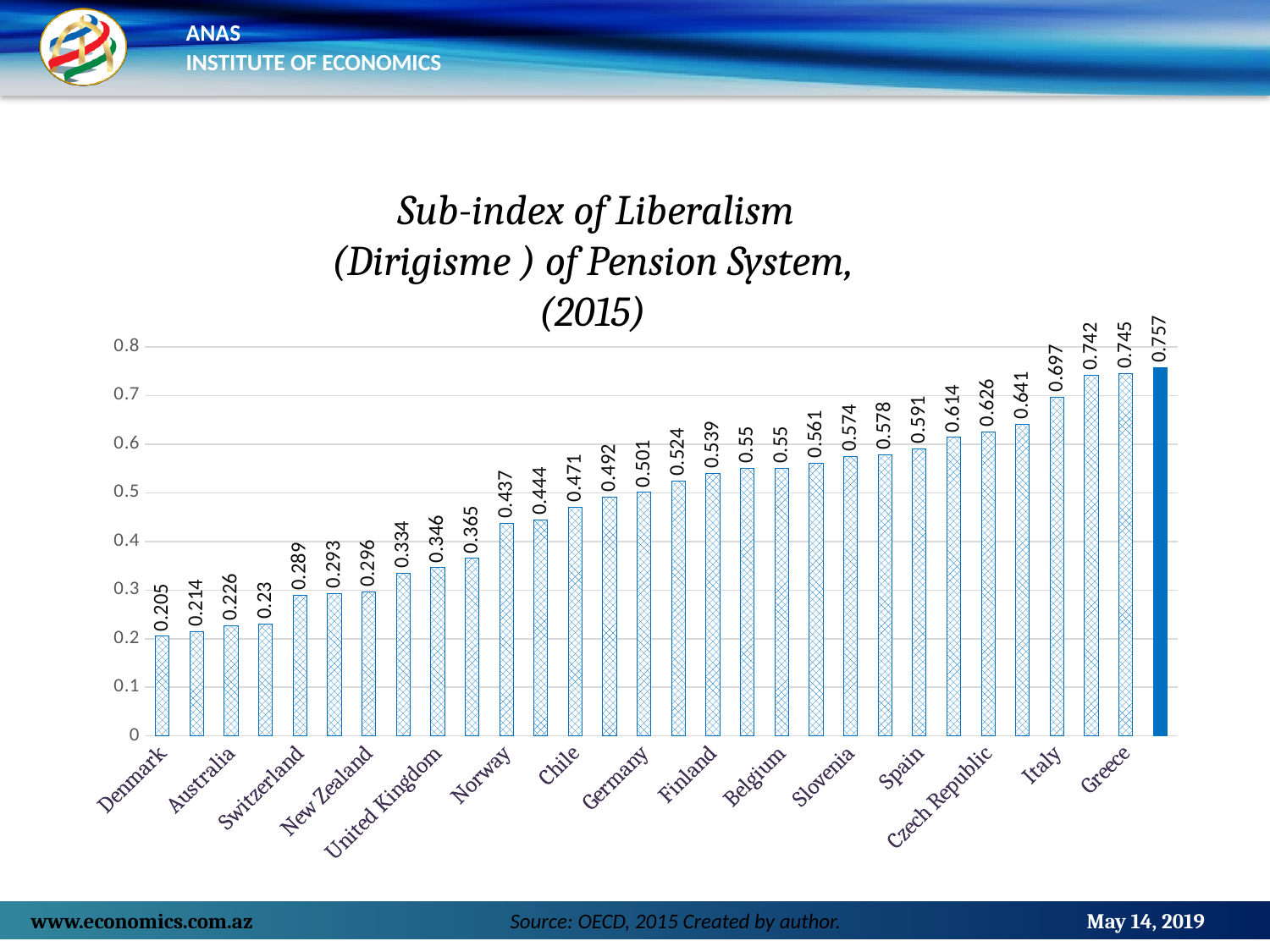
What year is given in the chart title? 2015 What kind of chart is shown on the slide? bar chart What is the value for Norway? 0.437 What is the value for Greece? 0.745 Which labelled country has the lowest value? Denmark Do the values rise or fall from left to right along the x axis? rise Which has a larger value, Italy or Spain? Italy What is the value for Czech Republic? 0.626 Is the value for Belgium greater or less than 0.6? less What is the highest value shown on the chart? 0.757 What is the value for Denmark? 0.205 What is the difference between the values for Greece and Denmark? 0.54